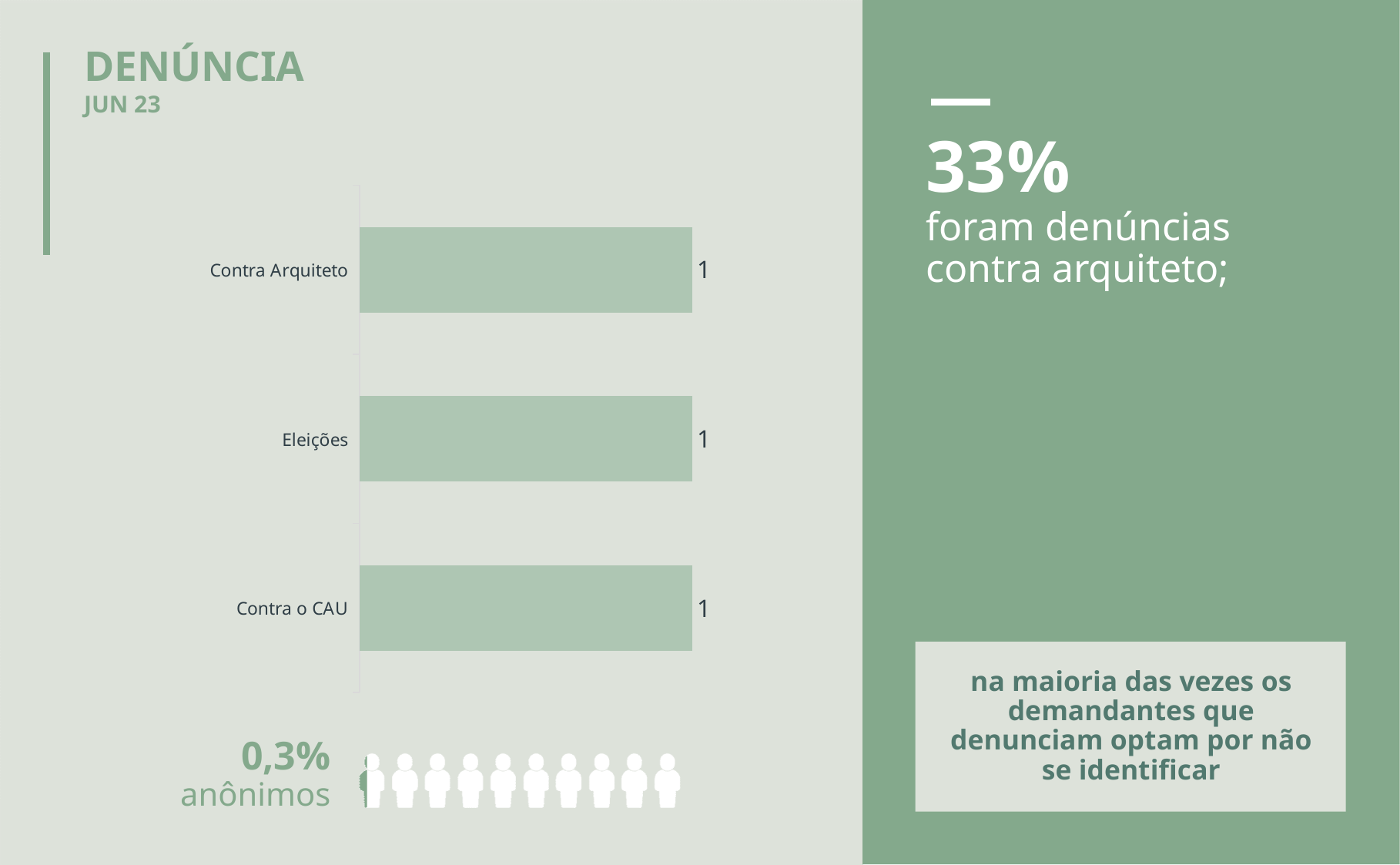
What is the sum of the values of all three bars in the chart? 3 What is the value for Contra Arquiteto in the bar chart? 1 What is the difference between the values for Contra Arquiteto and Eleições? 0 What is the value for Contra o CAU in the bar chart? 1 Which category is listed at the top of the bar chart? Contra Arquiteto Which category is listed at the bottom of the bar chart? Contra o CAU What kind of chart is shown on the slide? bar chart How many categories are shown in the bar chart? 3 Are the bars in the chart horizontal or vertical? horizontal What is the value for Eleições in the bar chart? 1